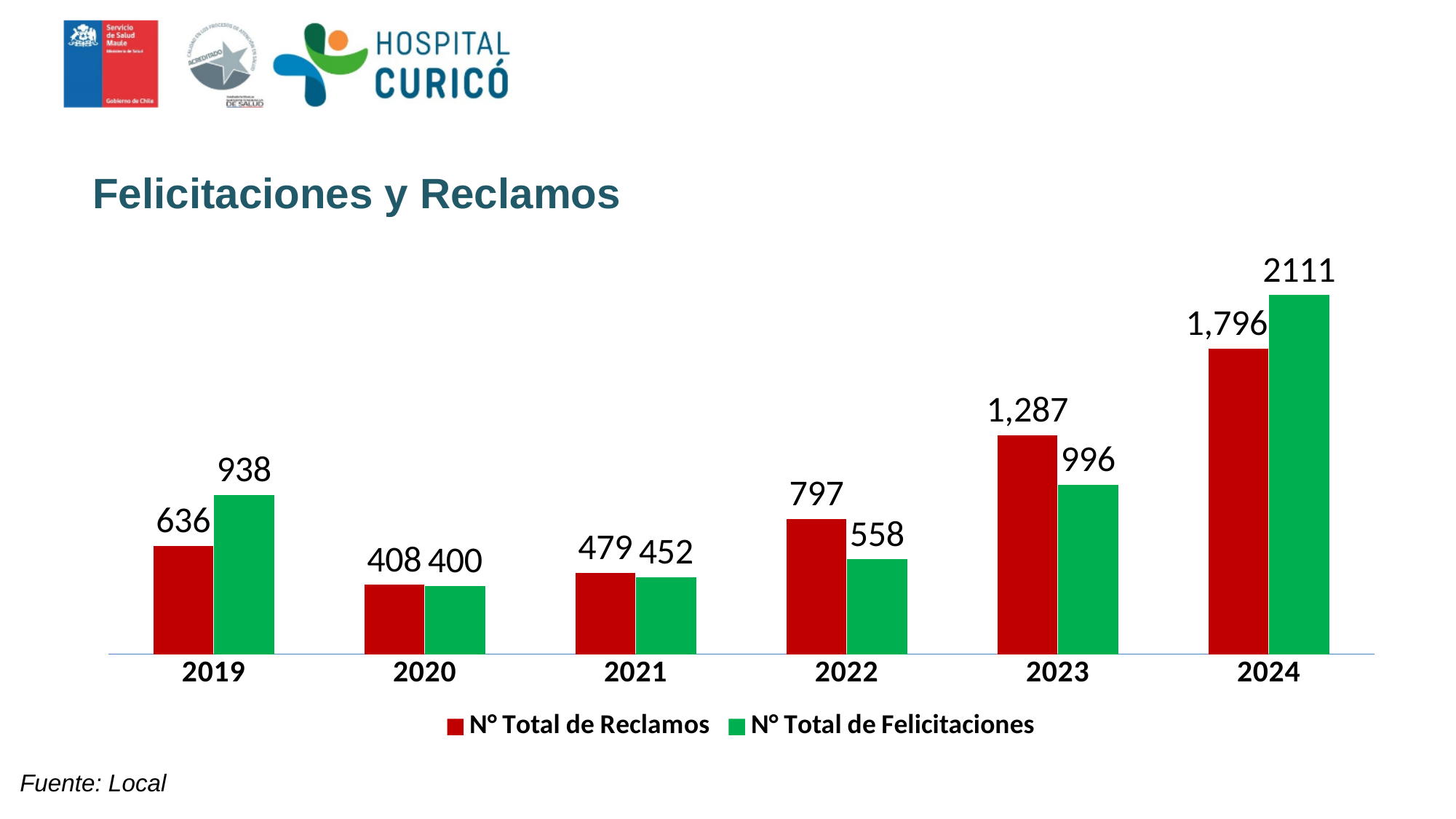
What is the difference between N° Total de Felicitaciones and N° Total de Reclamos in 2024? 315 What is the value of N° Total de Reclamos for 2023? 1,287 Which year has the highest value for N° Total de Felicitaciones? 2024 How many series does the legend list? 2 Which year has the lowest value for N° Total de Reclamos? 2020 How many years are shown on the x axis? 6 What is the value of N° Total de Reclamos for 2019? 636 What is the value of N° Total de Felicitaciones for 2022? 558 What kind of chart is shown on the slide? Bar chart In 2023, which is larger: N° Total de Reclamos or N° Total de Felicitaciones? N° Total de Reclamos What colour represents N° Total de Felicitaciones in the chart? Green What is the value of N° Total de Felicitaciones for 2024? 2111